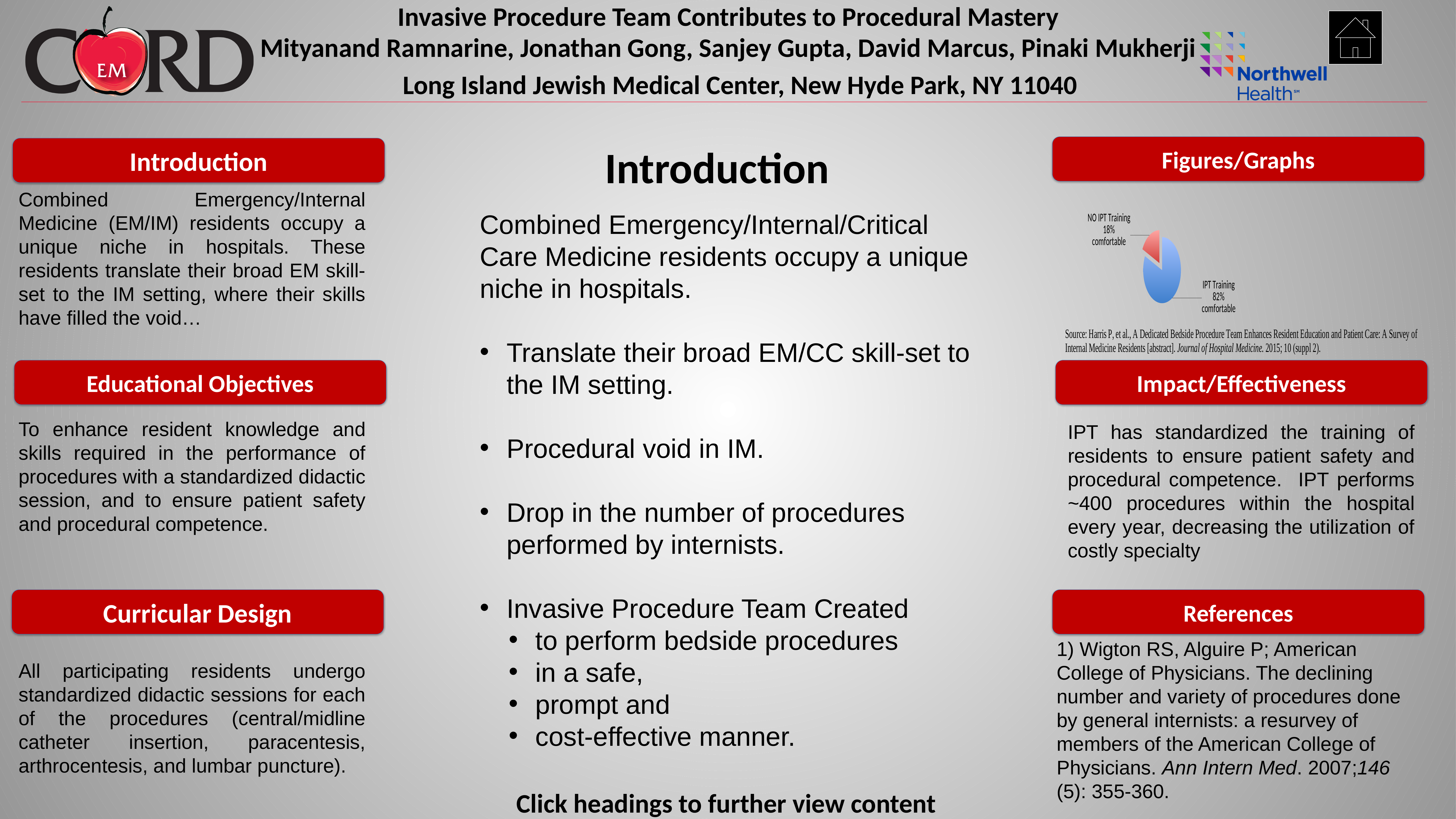
What percentage is shown for the NO IPT Training slice of the pie chart? 18% Which slice of the pie chart is the smallest? NO IPT Training Which slice of the pie chart is the largest? IPT Training How many slices does the pie chart have? 2 What share of the pie does the IPT Training slice represent? 82% What is the difference in percentage points between the IPT Training and NO IPT Training slices? 64 What colour is the NO IPT Training slice in the pie chart? red What colour is the IPT Training slice in the pie chart? blue Which is larger in the pie chart: IPT Training or NO IPT Training? IPT Training What kind of chart is shown in the Figures/Graphs section? pie chart What percentage is shown for the IPT Training slice of the pie chart? 82%